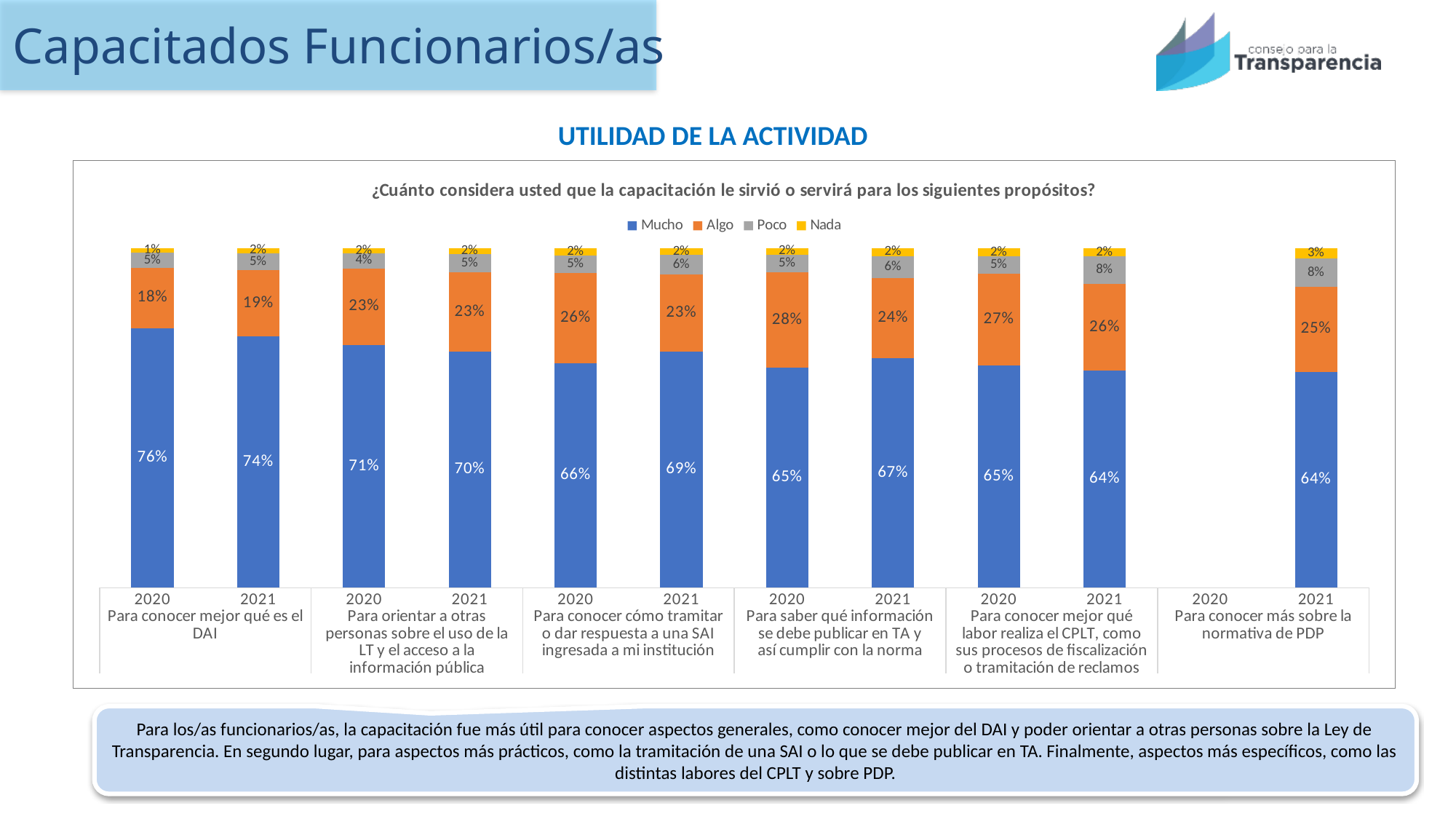
How many series does the chart legend list? 4 What is the 'Poco' value for 2021 under 'Para conocer más sobre la normativa de PDP'? 8% What is the 'Mucho' value for 2020 under 'Para conocer mejor qué es el DAI'? 76% What colour represents the 'Nada' series in the chart? Yellow What kind of chart is shown on the slide? Stacked bar chart Which bar has the highest 'Nada' value? 2021, Para conocer más sobre la normativa de PDP What is the 'Nada' value for 2020 under 'Para conocer mejor qué es el DAI'? 1% What is the difference between the 'Mucho' values for 2020 and 2021 under 'Para conocer cómo tramitar o dar respuesta a una SAI ingresada a mi institución'? 3% Which is larger: the 'Algo' value for 2020 or for 2021 under 'Para orientar a otras personas sobre el uso de la LT y el acceso a la información pública'? They are equal (23%) Which bar has the highest 'Mucho' value? 2020, Para conocer mejor qué es el DAI What is the 'Algo' value for 2020 under 'Para saber qué información se debe publicar en TA y así cumplir con la norma'? 28% Which year has no bar plotted under 'Para conocer más sobre la normativa de PDP'? 2020